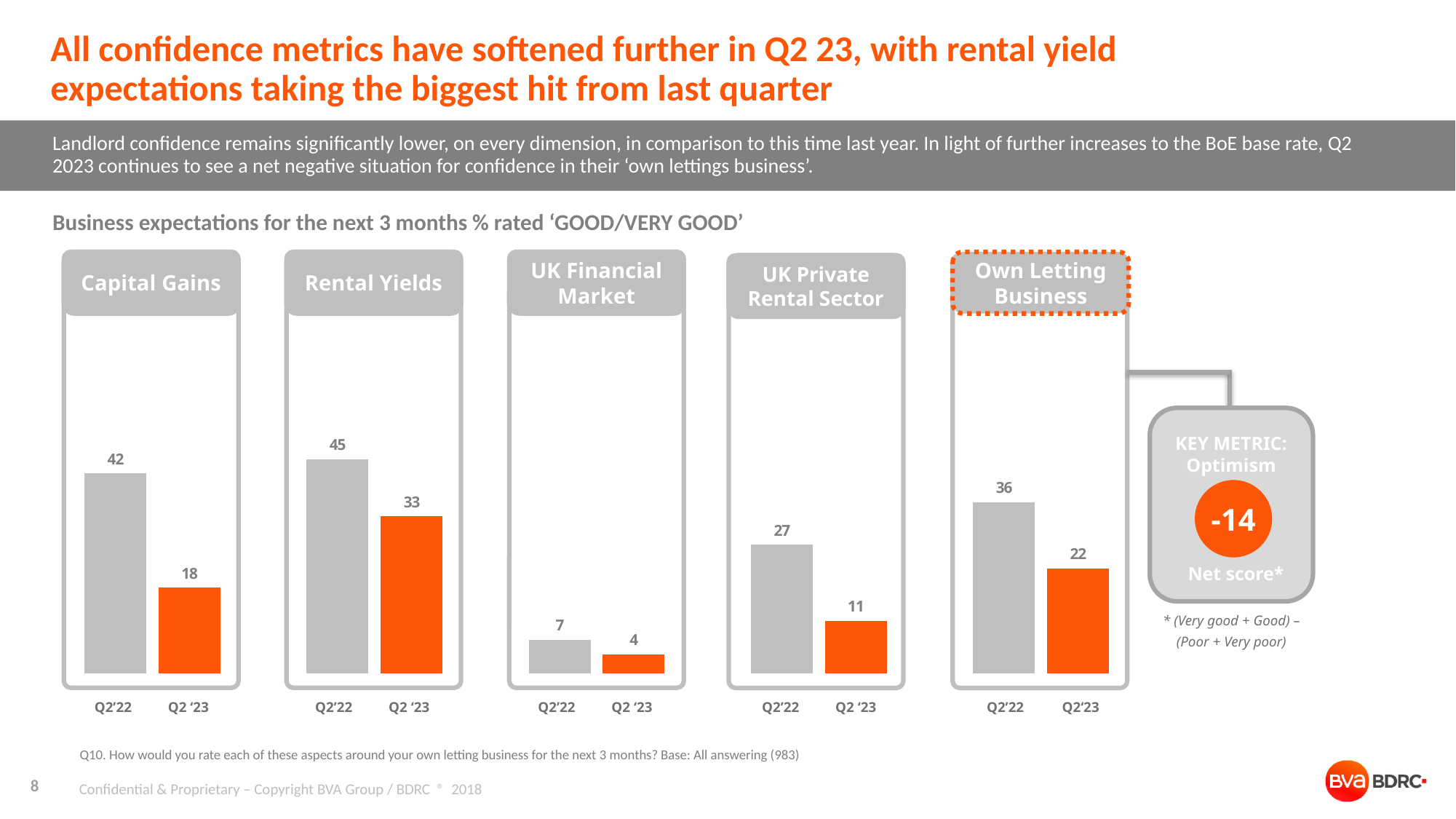
In the Rental Yields chart, what is the difference between the Q2'22 and Q2 '23 values? 12 In the UK Private Rental Sector chart, what is the value for Q2 '23? 11 In the UK Financial Market chart, which bar is lower, Q2'22 or Q2 '23? Q2 '23 In the UK Financial Market chart, what is the value for Q2'22? 7 In the Capital Gains chart, what is the value for Q2'22? 42 In the Own Letting Business chart, which is larger, the Q2'22 value or the Q2'23 value? Q2'22 What kind of chart is used for the Capital Gains panel? Bar chart In the Rental Yields chart, what is the value for Q2 '23? 33 In the UK Private Rental Sector chart, what is the difference between the Q2'22 and Q2 '23 values? 16 In the Capital Gains chart, do the values rise or fall from Q2'22 to Q2 '23? Fall In the Own Letting Business chart, what is the value for Q2'22? 36 In the Capital Gains chart, what is the value for Q2 '23? 18